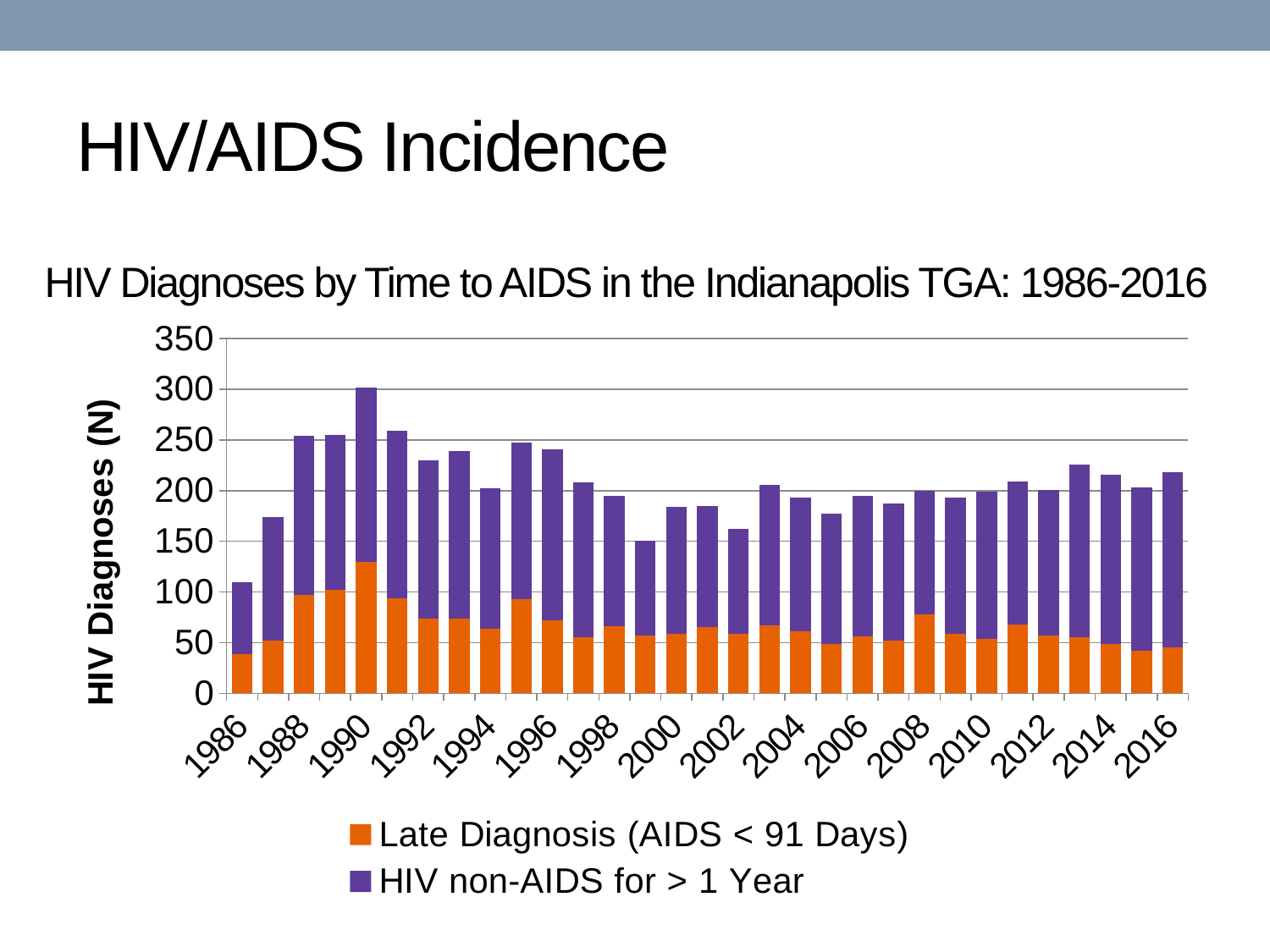
Which year has a larger total of HIV diagnoses, 1990 or 2000? 1990 What kind of chart is shown on the slide? Stacked bar chart What is the title of the chart? HIV Diagnoses by Time to AIDS in the Indianapolis TGA: 1986-2016 Is the total number of HIV diagnoses in 2000 greater or less than 200? less Is the total number of HIV diagnoses in 1986 greater or less than 150? less Which year has the lowest total number of HIV diagnoses? 1986 Is the total number of HIV diagnoses in 1990 greater or less than 250? greater Which year has the highest total number of HIV diagnoses? 1990 How many years (bars) are plotted in the chart? 31 Do the total HIV diagnoses rise or fall from 1990 to 2000? fall How many series does the legend list? 2